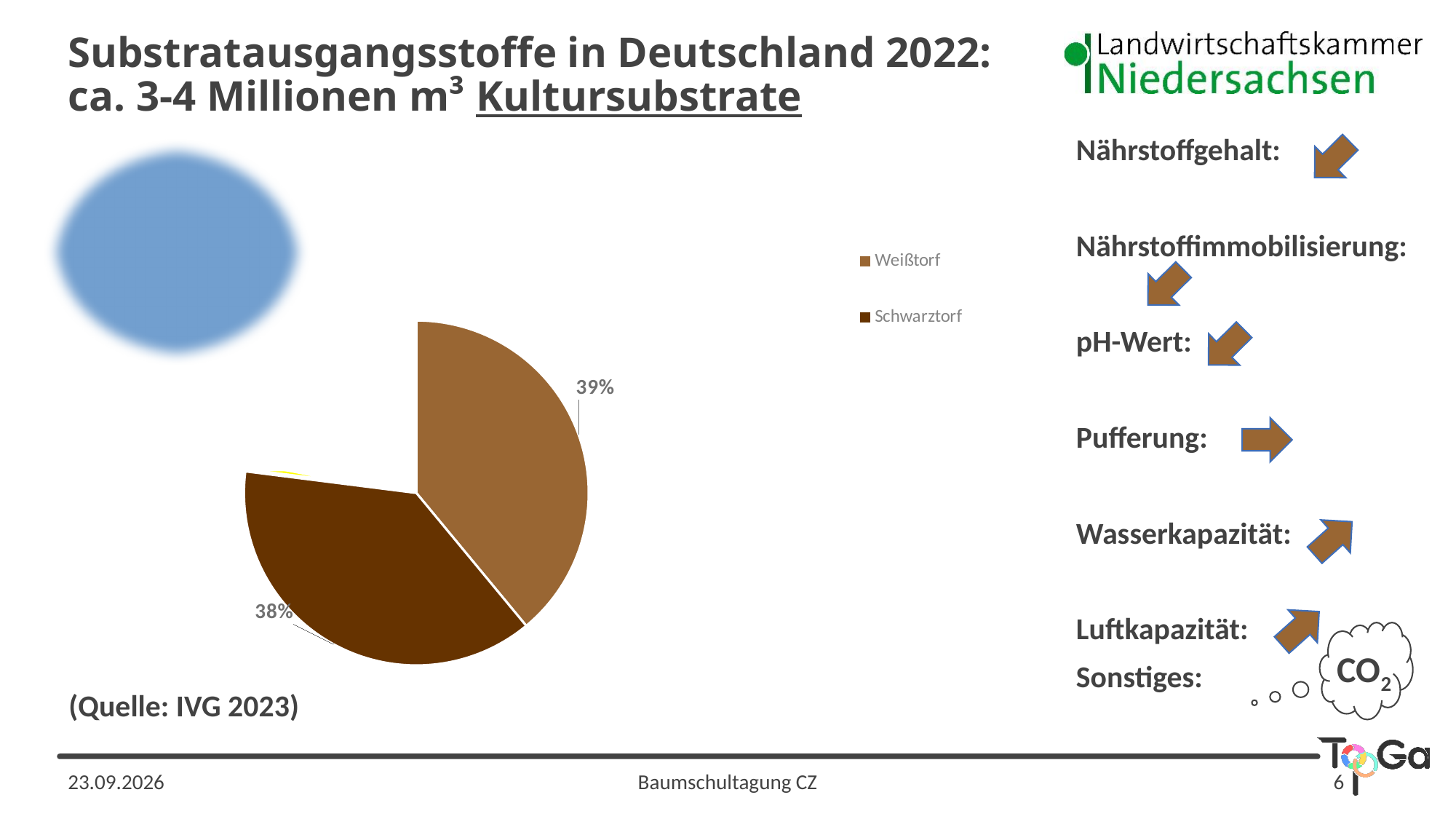
What kind of chart is shown on the slide? Pie chart Which has the larger labelled share, Weißtorf or Schwarztorf? Weißtorf Of the two labelled slices, which has the highest share? Weißtorf What is the difference in percentage points between the labelled shares of Weißtorf and Schwarztorf? 1 percentage point Which legend entry is shown in the dark brown colour? Schwarztorf Is the labelled share for Schwarztorf greater or less than 50%? less How many entries does the chart legend list? 2 What share of the pie chart is labelled for Weißtorf? 39% What source is cited below the pie chart? IVG 2023 What share of the pie chart is labelled for Schwarztorf? 38% Of the two labelled slices, which has the lowest share? Schwarztorf